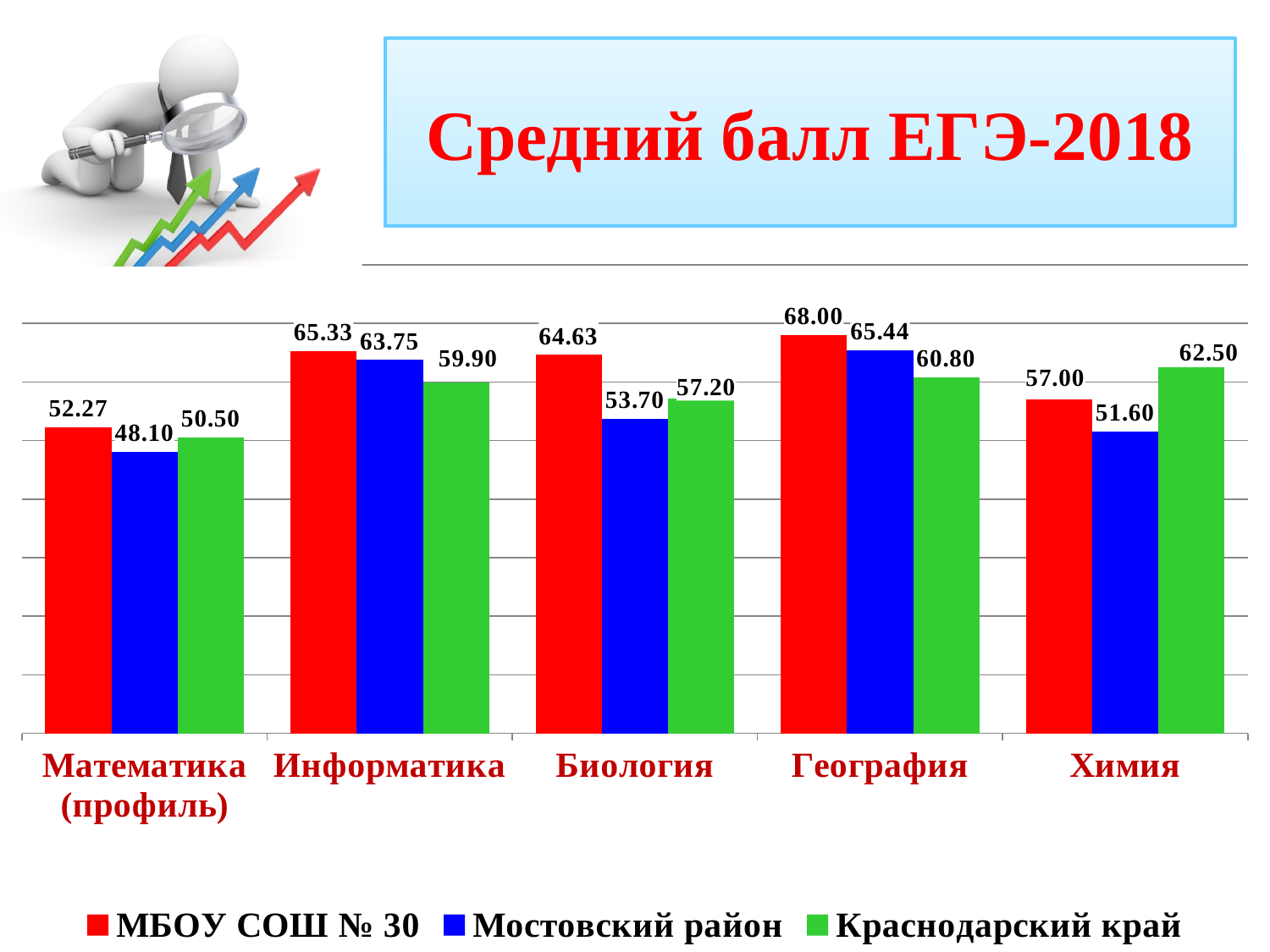
Which subject has the highest value for МБОУ СОШ № 30? География What is the title of the slide? Средний балл ЕГЭ-2018 What is the value for Краснодарский край in Химия? 62.50 What is the value for Мостовский район in Биология? 53.70 How many series does the legend list? 3 What is the difference between Краснодарский край and МБОУ СОШ № 30 in Химия? 5.50 What is the difference between МБОУ СОШ № 30 and Краснодарский край in География? 7.20 Which is larger in Биология: Мостовский район or Краснодарский край? Краснодарский край How many subjects are shown on the x axis? 5 What kind of chart is shown on the slide? Bar chart What is the value for МБОУ СОШ № 30 in Информатика? 65.33 Which subject has the lowest value for Мостовский район? Математика (профиль)